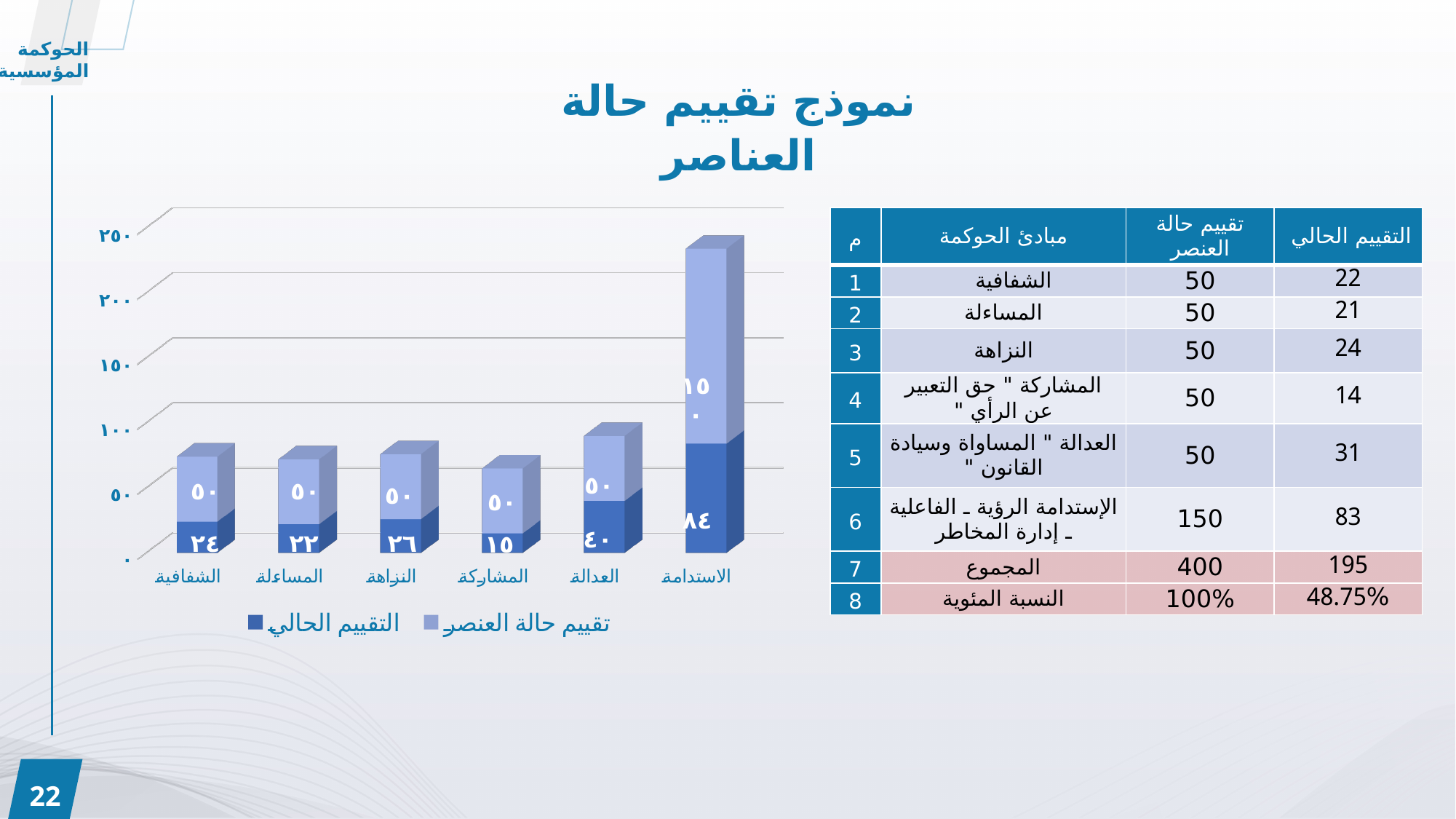
What is the value of تقييم حالة العنصر for الاستدامة in the chart? ١٥٠ What is the value of التقييم الحالي for العدالة in the chart? ٤٠ What is the difference between the التقييم الحالي values for العدالة and المشاركة? ٢٥ What kind of chart is shown on the slide? bar chart Which has the larger التقييم الحالي value, النزاهة or المساءلة? النزاهة How many categories are shown on the x axis of the chart? 6 What is the value of التقييم الحالي for الشفافية in the chart? ٢٤ What is the total of the stacked bar for الاستدامة? ٢٣٤ What are the two series names listed in the chart legend? التقييم الحالي and تقييم حالة العنصر How many series does the chart legend list? 2 Which category has the highest التقييم الحالي value in the chart? الاستدامة Which category has the lowest التقييم الحالي value in the chart? المشاركة